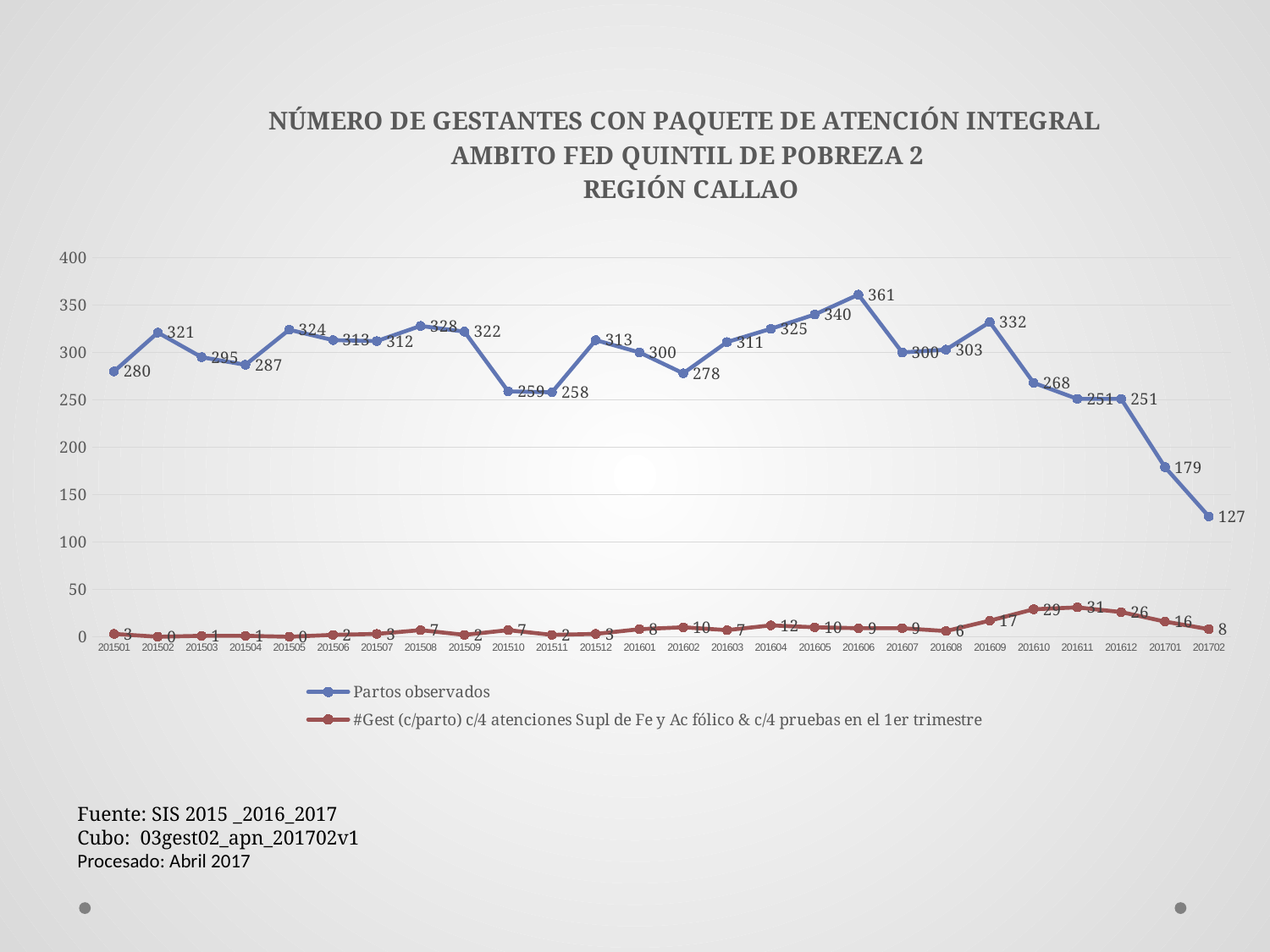
How many periods are plotted on the x axis? 26 What is the value of Partos observados for 201606? 361 What is the value of the #Gest (c/parto) series for 201611? 31 In which period does Partos observados reach its lowest value? 201702 What is the value of Partos observados for 201702? 127 In which period does Partos observados reach its highest value? 201606 How many series does the legend list? 2 In which period does the #Gest (c/parto) series reach its highest value? 201611 Which is larger, Partos observados in 201502 or in 201503? 201502 What type of chart is shown on the slide? line chart Does Partos observados rise or fall from 201612 to 201702? fall What is the difference between Partos observados in 201701 and 201702? 52